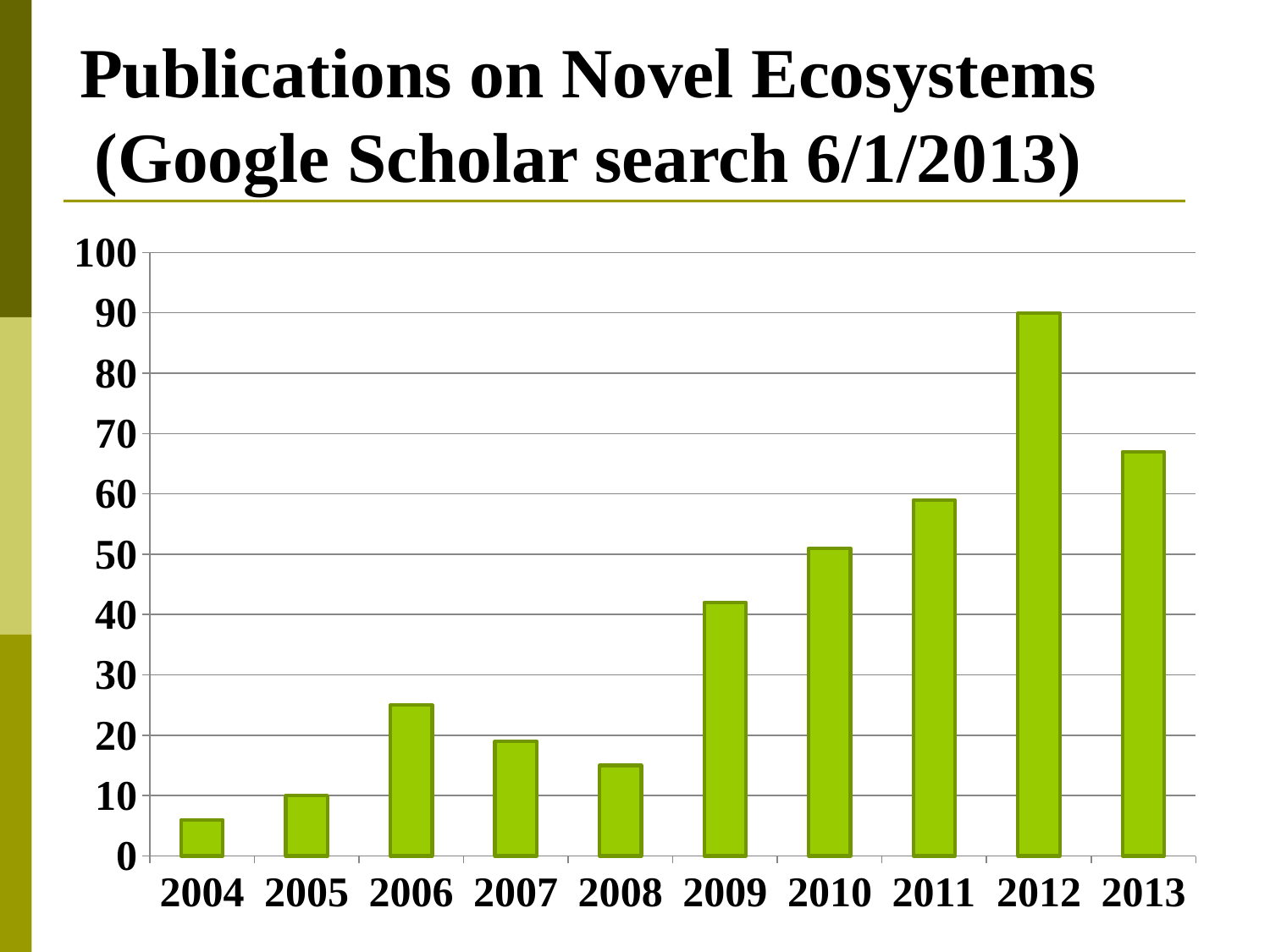
What type of chart is shown on the slide? bar chart Which is larger, the value for 2011 or the value for 2013? 2013 What is the value for 2005? 10 Which year has the highest number of publications? 2012 What is the value for 2012? 90 Which year has the lowest number of publications? 2004 Is the value for 2013 greater or less than 60? greater Is the value for 2008 greater or less than 20? less How many years are shown on the x axis of the chart? 10 What is the title of the chart on the slide? Publications on Novel Ecosystems (Google Scholar search 6/1/2013) Which is larger, the value for 2006 or the value for 2007? 2006